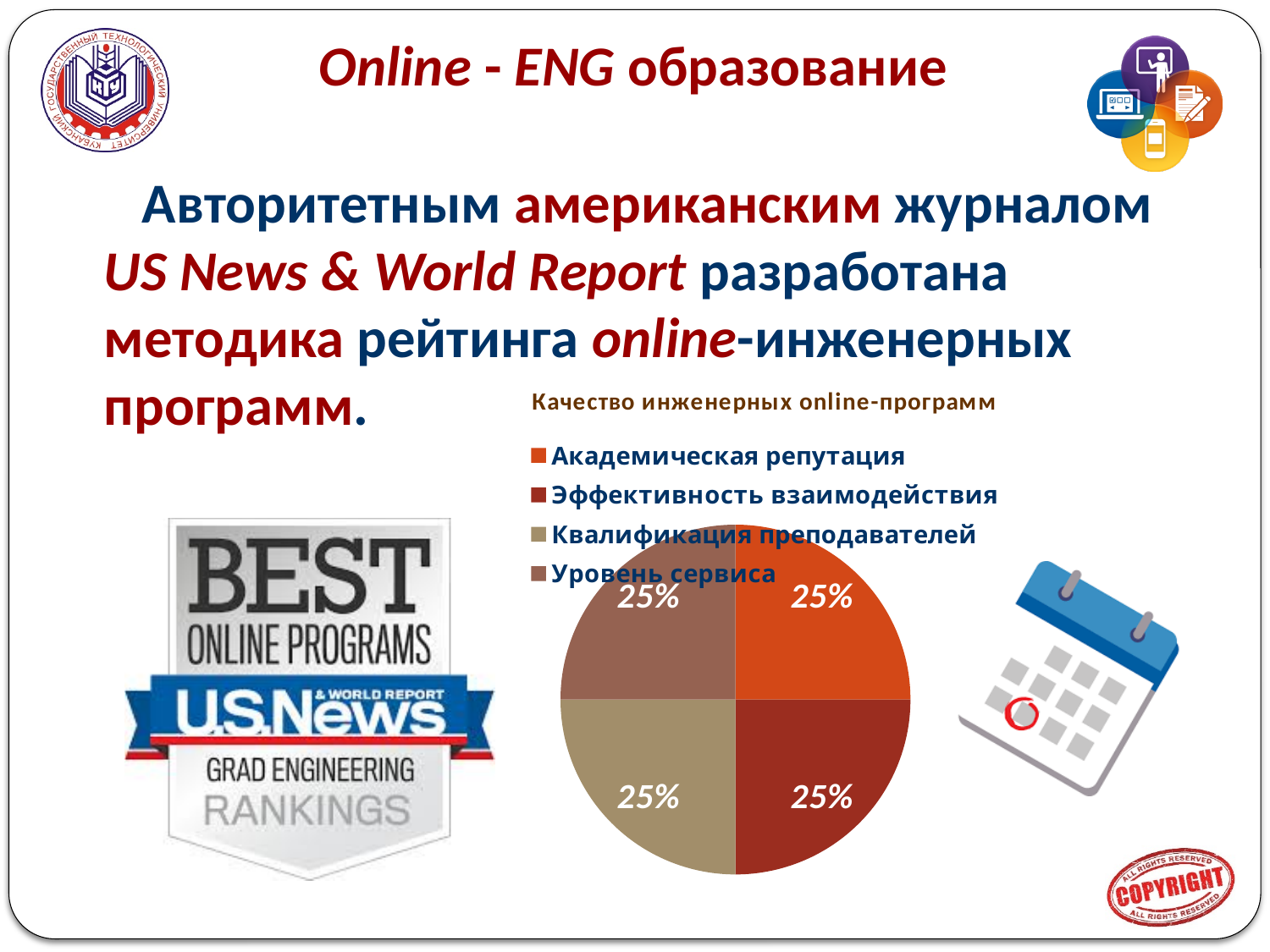
Which legend entry is shown in orange in the pie chart? Академическая репутация What share of the pie does Академическая репутация take? 25% What is the value shown for Уровень сервиса? 25% How many entries does the legend of the pie chart list? 4 What is the difference between the values for Академическая репутация and Уровень сервиса? 0% What is the value shown for Эффективность взаимодействия? 25% What is the total of all four slices in the pie chart? 100% What kind of chart is shown on the slide? pie chart What is the title of the pie chart? Качество инженерных online-программ What is the value shown for Квалификация преподавателей? 25% How many slices does the pie chart have? 4